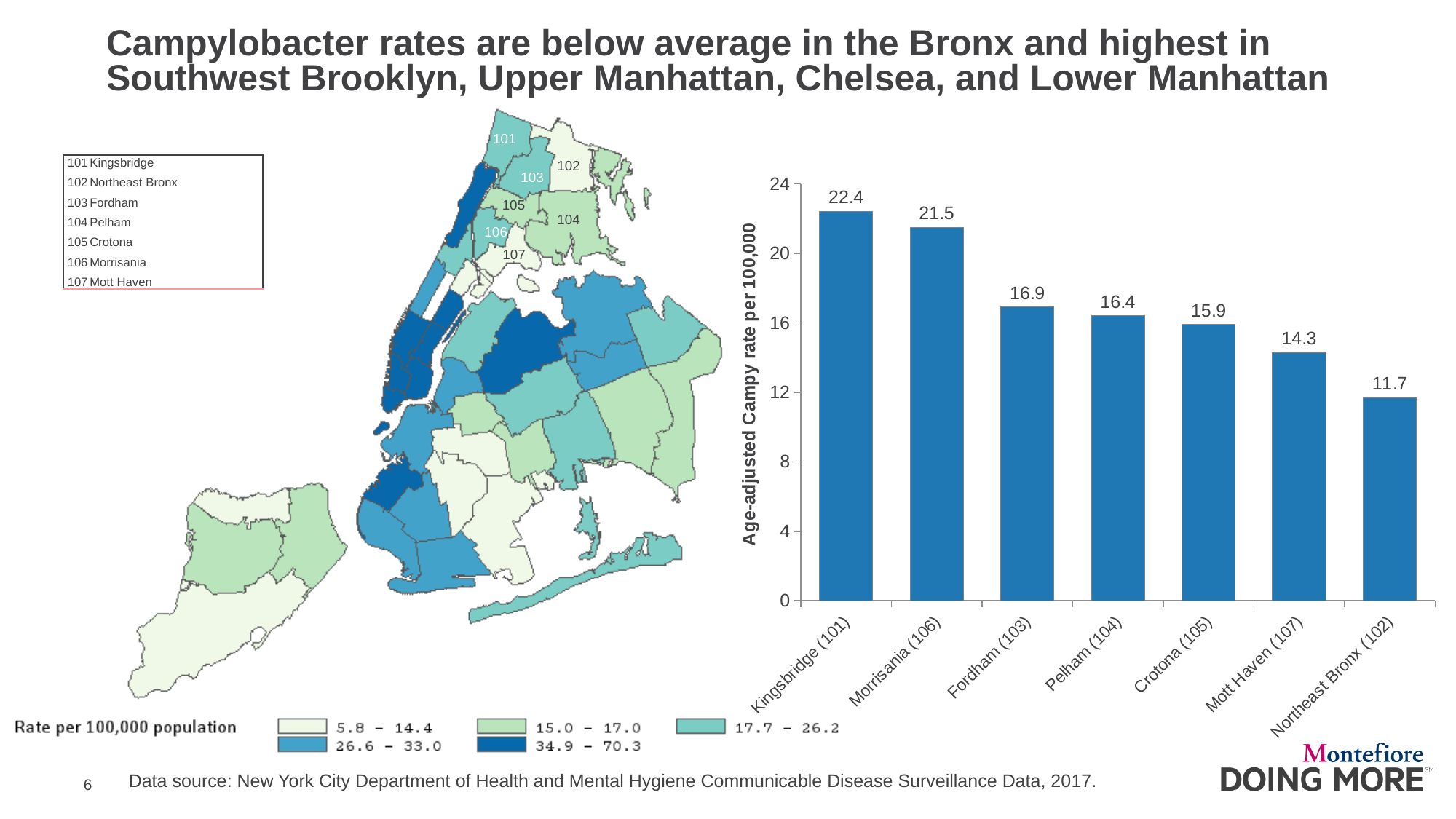
Which has a higher Campy rate, Crotona (105) or Mott Haven (107)? Crotona (105) What is the age-adjusted Campy rate per 100,000 for Fordham (103)? 16.9 What is the label of the vertical axis of the bar chart? Age-adjusted Campy rate per 100,000 How many districts are shown in the bar chart? 7 What is the age-adjusted Campy rate per 100,000 for Mott Haven (107)? 14.3 What type of chart is used to show the age-adjusted Campy rates? bar chart Which district has the highest age-adjusted Campy rate in the bar chart? Kingsbridge (101) What is the difference between the Campy rates for Morrisania (106) and Pelham (104)? 5.1 What is the difference between the Campy rates for Kingsbridge (101) and Northeast Bronx (102)? 10.7 Which district has the lowest age-adjusted Campy rate in the bar chart? Northeast Bronx (102) Is the Campy rate for Morrisania (106) greater or less than 20? greater What is the age-adjusted Campy rate per 100,000 for Kingsbridge (101)? 22.4